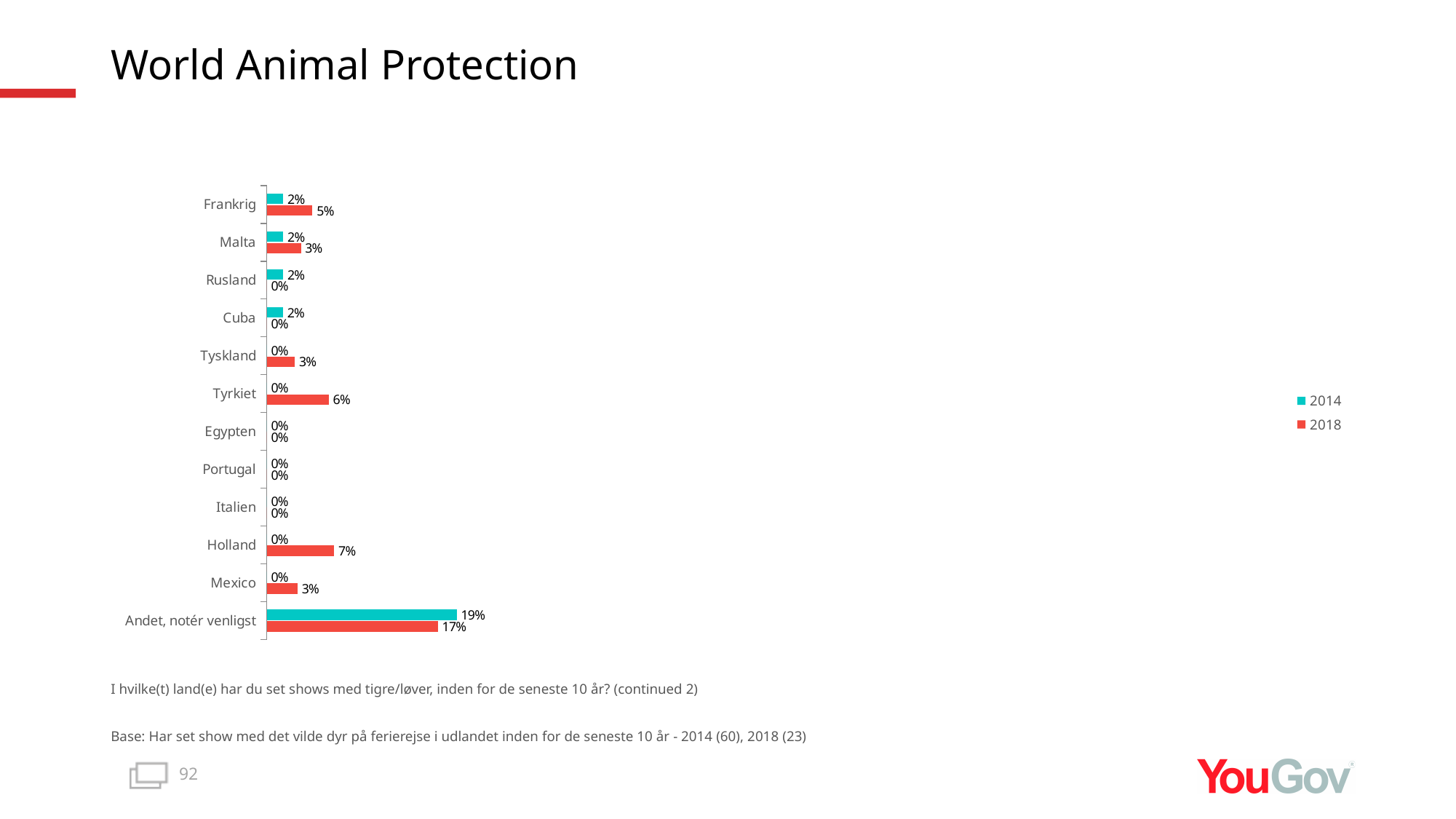
What is the 2014 value for Frankrig? 2% What is the difference between the 2014 and 2018 values for Andet, notér venligst? 2% What is the 2014 value for Andet, notér venligst? 19% How many series does the legend list? 2 What is the 2018 value for Holland? 7% What kind of chart is shown on the slide? Bar chart How many categories are shown on the chart? 12 What is the 2018 value for Tyrkiet? 6% Which is larger for Malta: the 2014 value or the 2018 value? 2018 Which category has the highest 2018 value? Andet, notér venligst What is the difference between the 2018 and 2014 values for Frankrig? 3% Excluding Andet, notér venligst, which country has the highest 2018 value? Holland